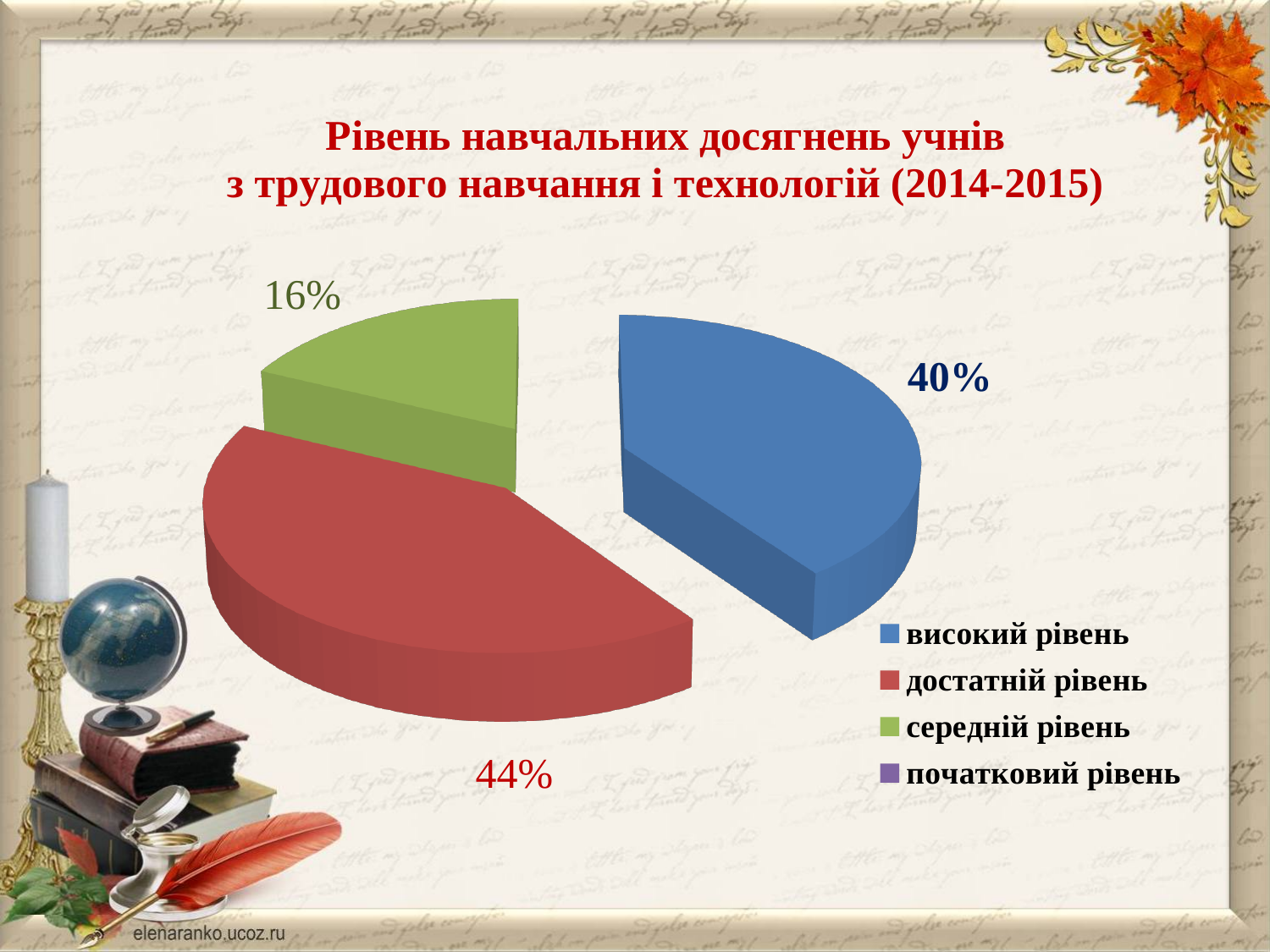
What is the value for середній рівень? 16% What is the difference between the values for достатній рівень and високий рівень? 4% What is the value for достатній рівень? 44% What colour is the slice for достатній рівень? red Which legend entry has no visible slice in the pie? початковий рівень Which category with a visible slice has the smallest share of the pie? середній рівень How many entries does the legend list? 4 Which category has the largest share of the pie? достатній рівень What is the difference between the values for достатній рівень and середній рівень? 28% Which is larger, the value for високий рівень or the value for середній рівень? високий рівень What is the value for високий рівень? 40% What kind of chart is shown on the slide? pie chart